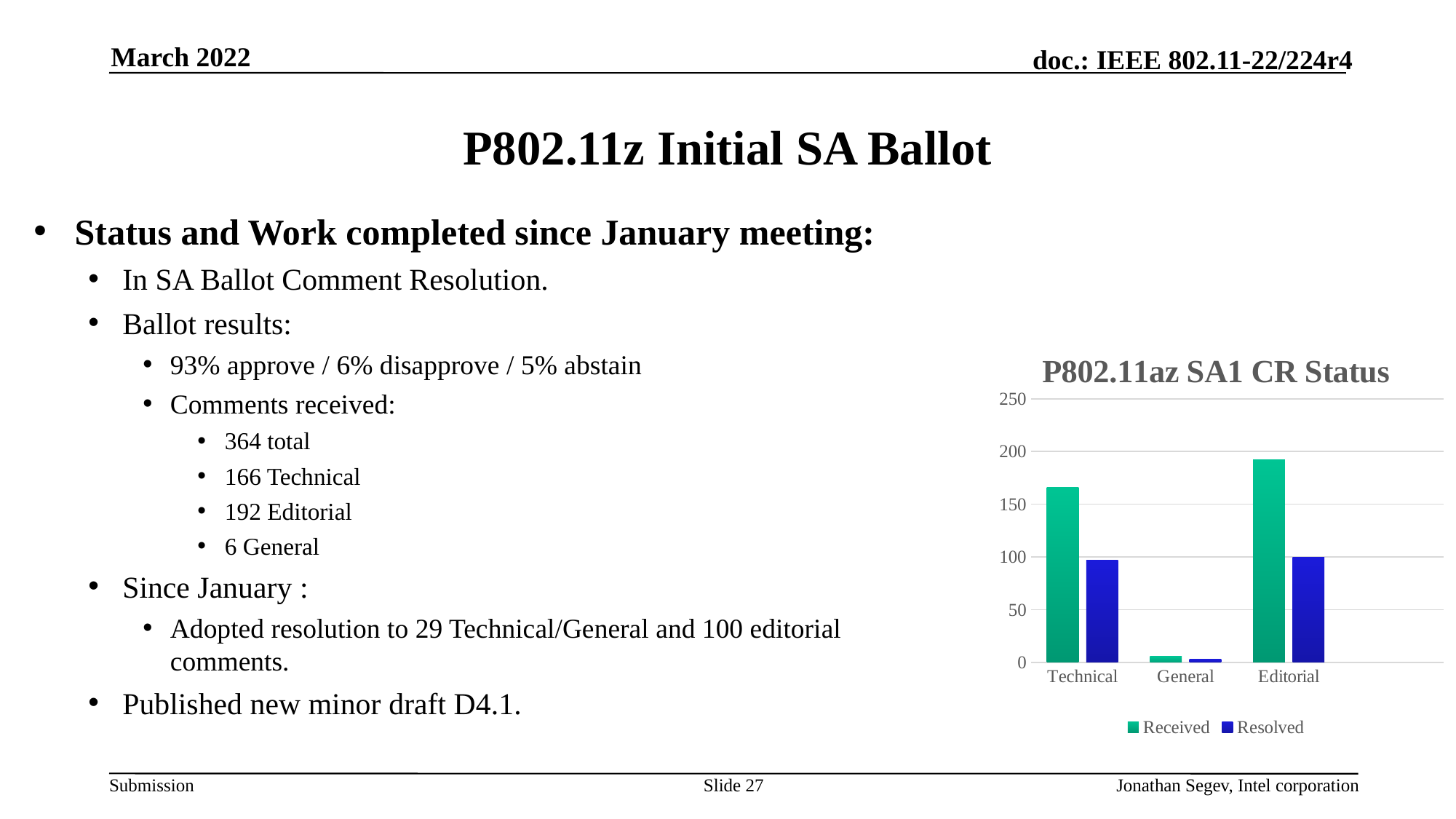
Is the Received value for Technical greater or less than 150? greater What is the title of the chart? P802.11az SA1 CR Status Which category has the lowest Received value? General For Technical, which is larger, Received or Resolved? Received What kind of chart is shown on the slide? bar chart Is the Received value for Editorial greater or less than 200? less Is the Resolved value for Technical greater or less than 50? greater Which category has the highest Received value? Editorial How many categories are shown on the x axis of the chart? 3 How many series does the chart legend list? 2 Which category has the lowest Resolved value? General Which series is shown in dark blue in the chart? Resolved